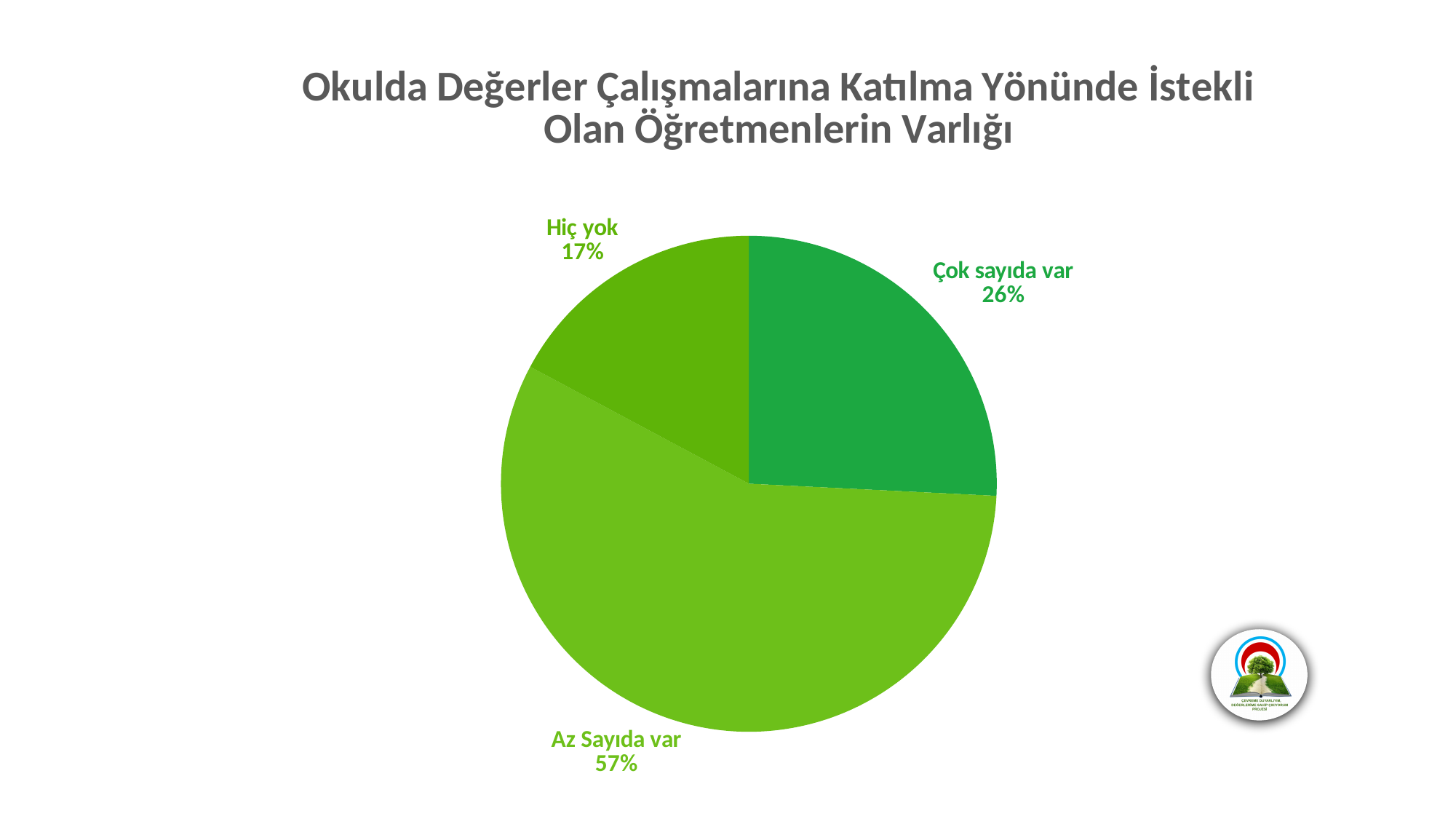
What is the difference in percentage points between "Az Sayıda var" and "Çok sayıda var"? 31 Which category has the smallest slice of the pie? Hiç yok What is the difference in percentage points between "Çok sayıda var" and "Hiç yok"? 9 What percentage is shown for "Hiç yok"? 17% How many slices does the pie chart have? 3 Which category has the largest slice of the pie? Az Sayıda var What kind of chart is shown on the slide? pie chart Which is larger, the slice for "Çok sayıda var" or the slice for "Hiç yok"? Çok sayıda var What percentage is shown for "Çok sayıda var"? 26% What percentage is shown for "Az Sayıda var"? 57% What is the title of the chart? Okulda Değerler Çalışmalarına Katılma Yönünde İstekli Olan Öğretmenlerin Varlığı What share of the pie does "Az Sayıda var" represent? 57%